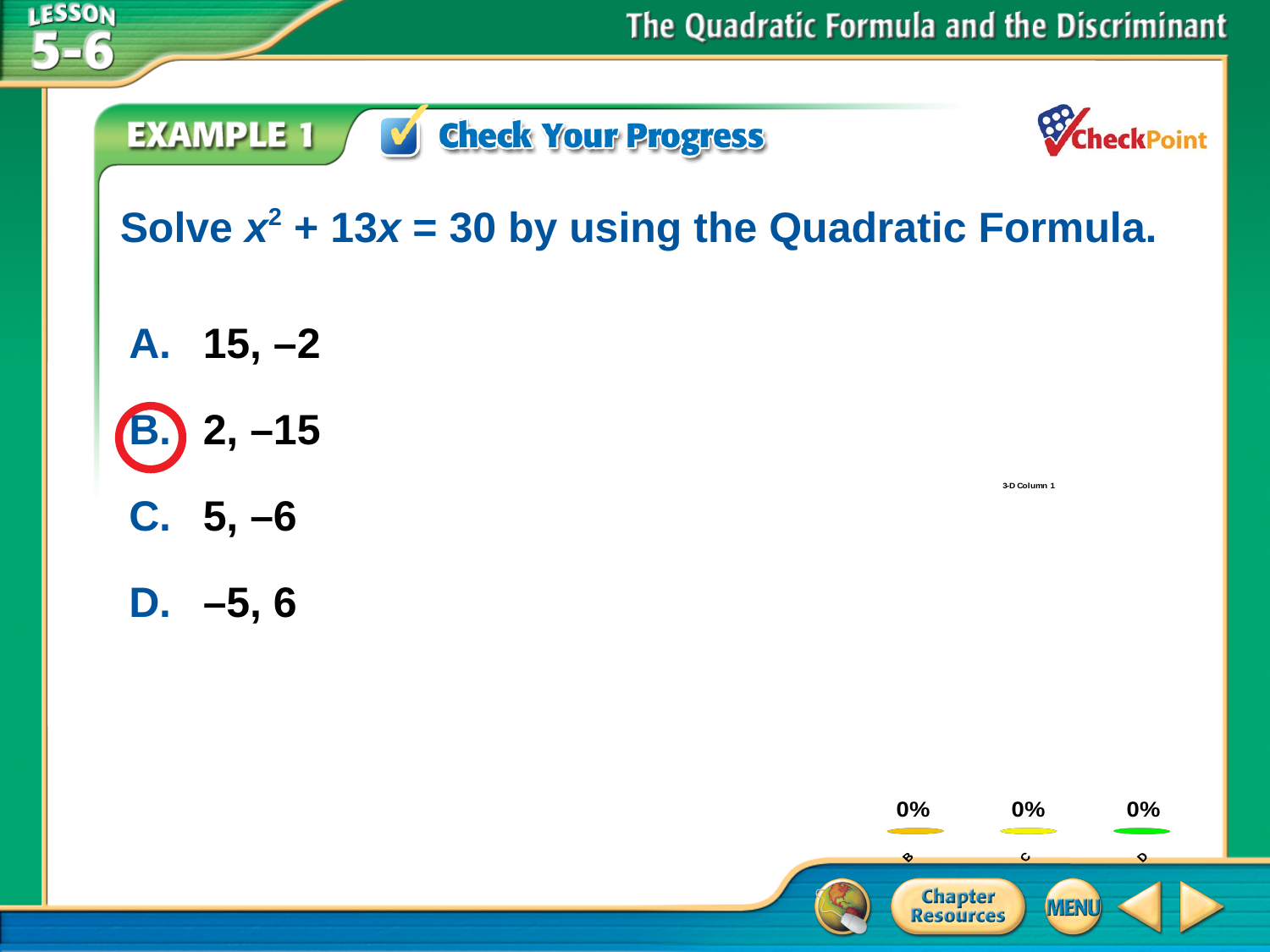
What value is shown for category C in the chart at the bottom right of the slide? 0% What is the difference between the values for B and C in the chart at the bottom right of the slide? 0% What is the title of the chart at the bottom right of the slide? 3-D Column 1 What kind of chart is shown at the bottom right of the slide? bar chart Do the values in the chart at the bottom right of the slide rise, fall, or stay the same from B to D? stay the same What value is shown for category D in the chart at the bottom right of the slide? 0% What is the difference between the values for C and D in the chart at the bottom right of the slide? 0% What value is shown for category B in the chart at the bottom right of the slide? 0%